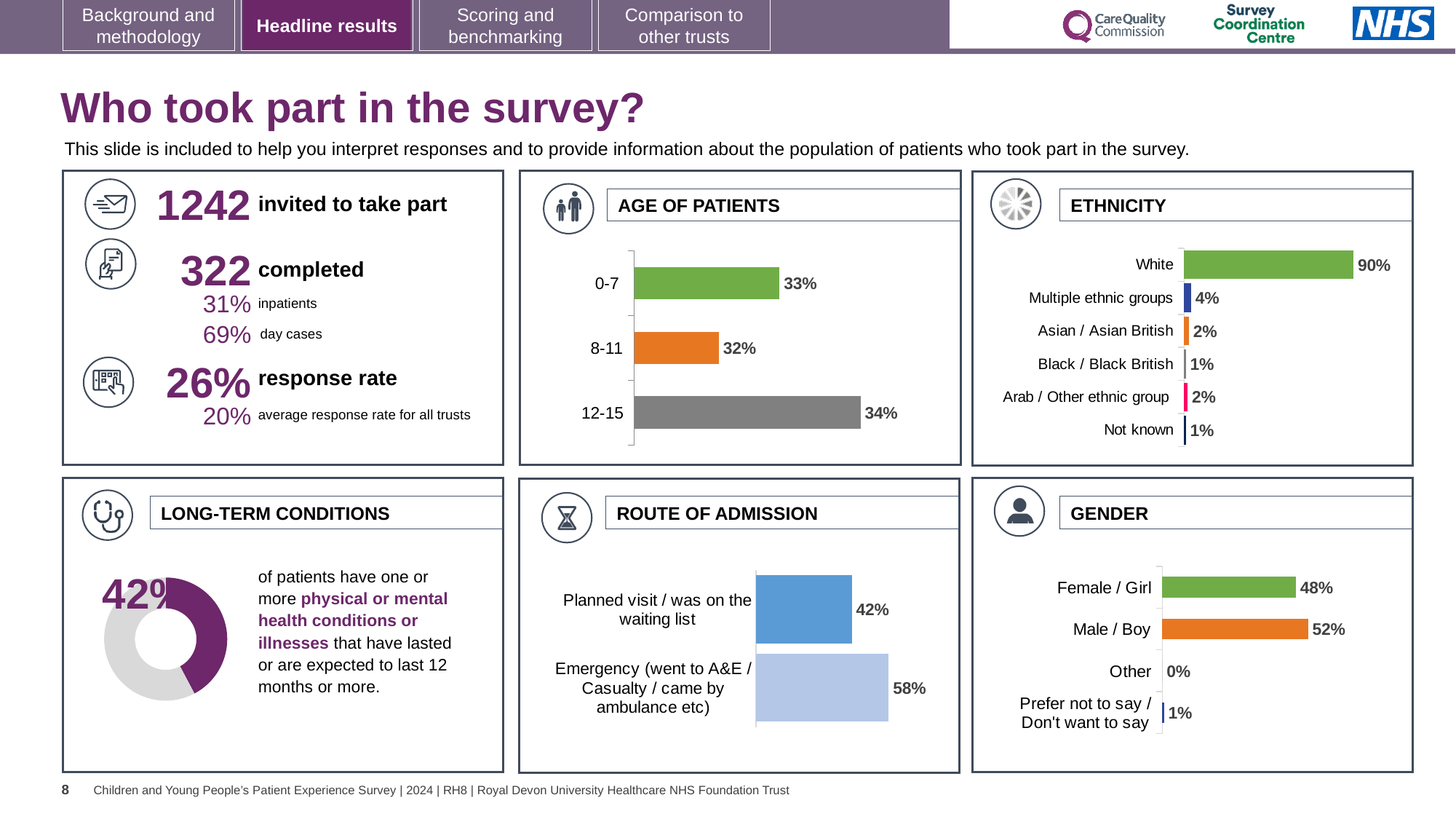
In the GENDER chart, what is the difference between the Male / Boy and Female / Girl percentages? 4% In the AGE OF PATIENTS chart, which age group has the lowest percentage? 8-11 In the ETHNICITY chart, what is the difference between the White and Multiple ethnic groups percentages? 86% In the GENDER chart, which category has the highest percentage? Male / Boy In the AGE OF PATIENTS chart, what percentage of patients were aged 12-15? 34% In the GENDER chart, what percentage of patients were Male / Boy? 52% In the ETHNICITY chart, what percentage of patients were White? 90% How many categories are shown in the ETHNICITY chart? 6 In the LONG-TERM CONDITIONS chart, what percentage of patients have one or more long-term conditions? 42% What kind of chart is used in the LONG-TERM CONDITIONS panel? Doughnut chart In the ROUTE OF ADMISSION chart, which route has the higher percentage: Planned visit / was on the waiting list or Emergency? Emergency (went to A&E / Casualty / came by ambulance etc) In the ROUTE OF ADMISSION chart, what percentage of patients came via Emergency (went to A&E / Casualty / came by ambulance etc)? 58%